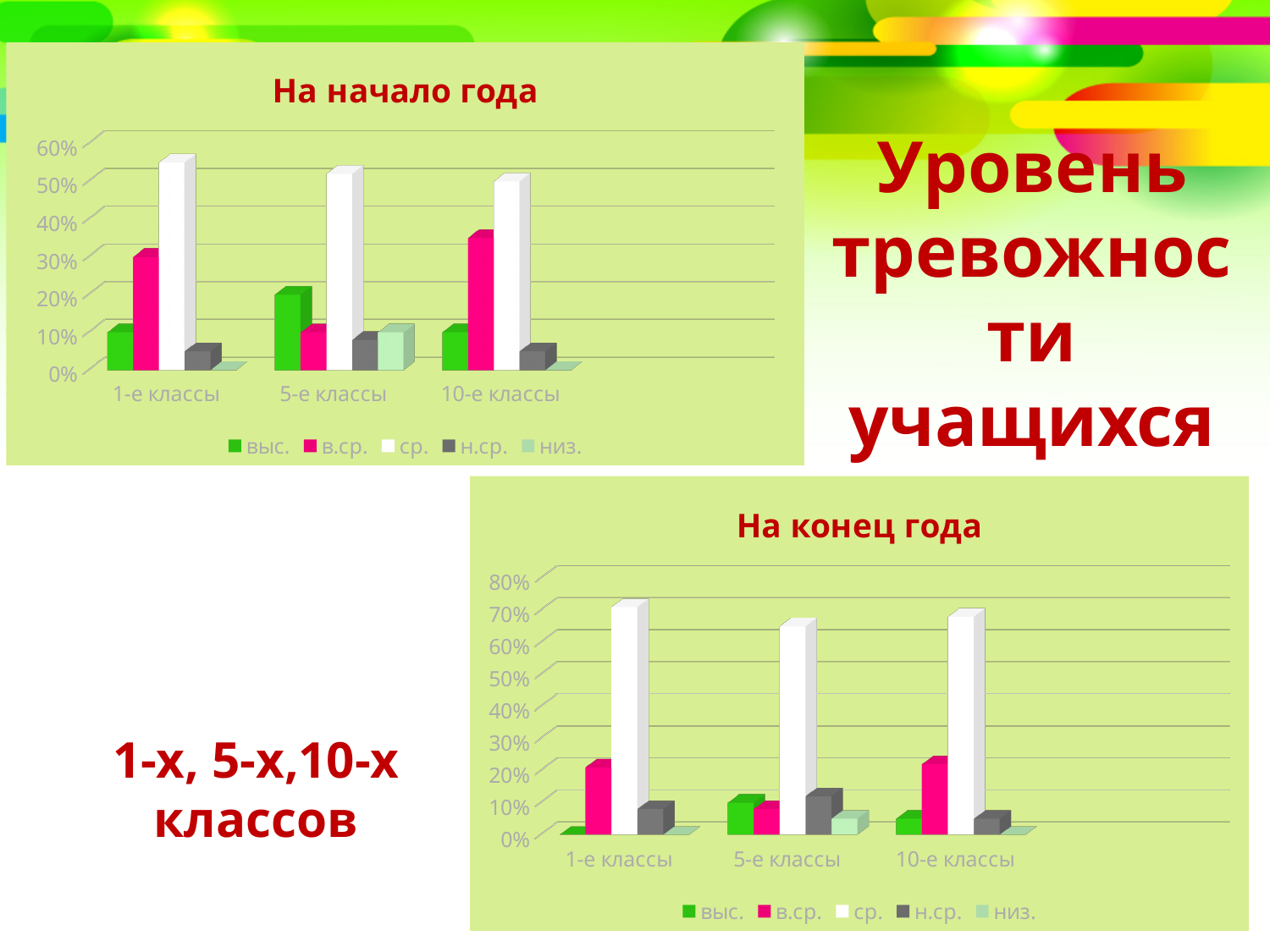
In the "На начало года" chart, for 5-е классы, which is larger: выс. or в.ср.? выс. In the "На начало года" chart, is the value of в.ср. for 10-е классы greater or less than 20%? greater In the "На конец года" chart, is the value of ср. for 1-е классы greater or less than 60%? greater In the "На конец года" chart, which series has the highest value for 10-е классы? ср. In the "На начало года" chart, is the value of ср. for 1-е классы greater or less than 40%? greater What kind of chart is "На начало года"? bar chart How many categories are shown on the x axis of the "На конец года" chart? 3 How many series does the legend of the "На начало года" chart list? 5 In the "На конец года" chart, for 1-е классы, which is larger: выс. or в.ср.? в.ср. In the "На начало года" chart, which series has the highest value for 1-е классы? ср. What is the title of the chart in the upper left of the slide? На начало года